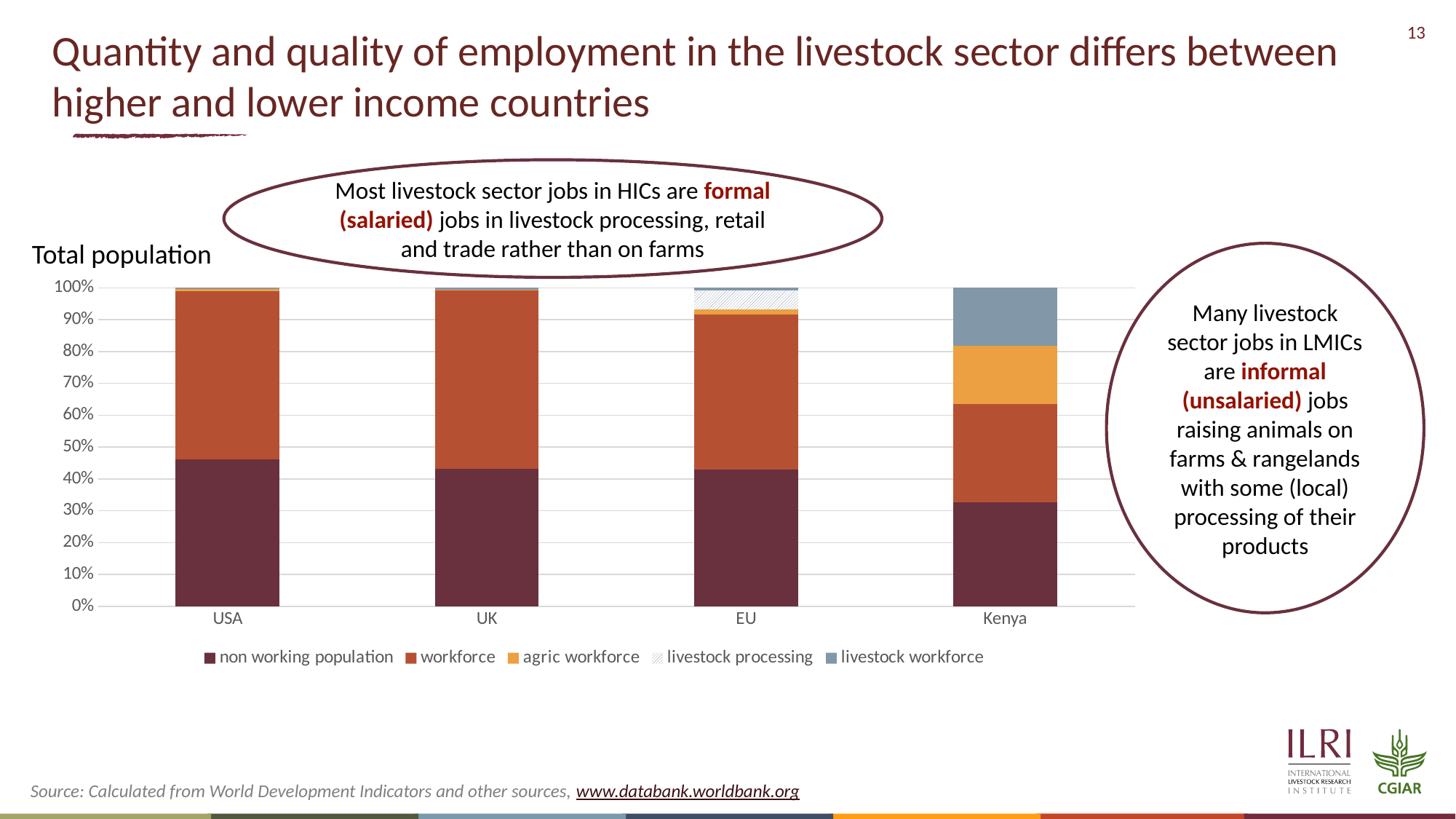
What is the title shown above the chart? Total population Which is larger, the non working population share for USA or for Kenya? USA How many countries or regions are shown on the x axis of the chart? 4 Which country or region has the largest agric workforce share? Kenya Which country or region has the largest livestock workforce share? Kenya Is the non working population share for Kenya greater or less than 40%? less Is the non working population share for USA greater or less than 40%? greater How many series does the chart legend list? 5 Is the livestock workforce share for Kenya greater or less than 10%? greater What kind of chart is shown on the slide? Stacked bar chart Which legend entry is shown with a hatched pattern rather than a solid colour? livestock processing Which country or region has the smallest non working population share? Kenya